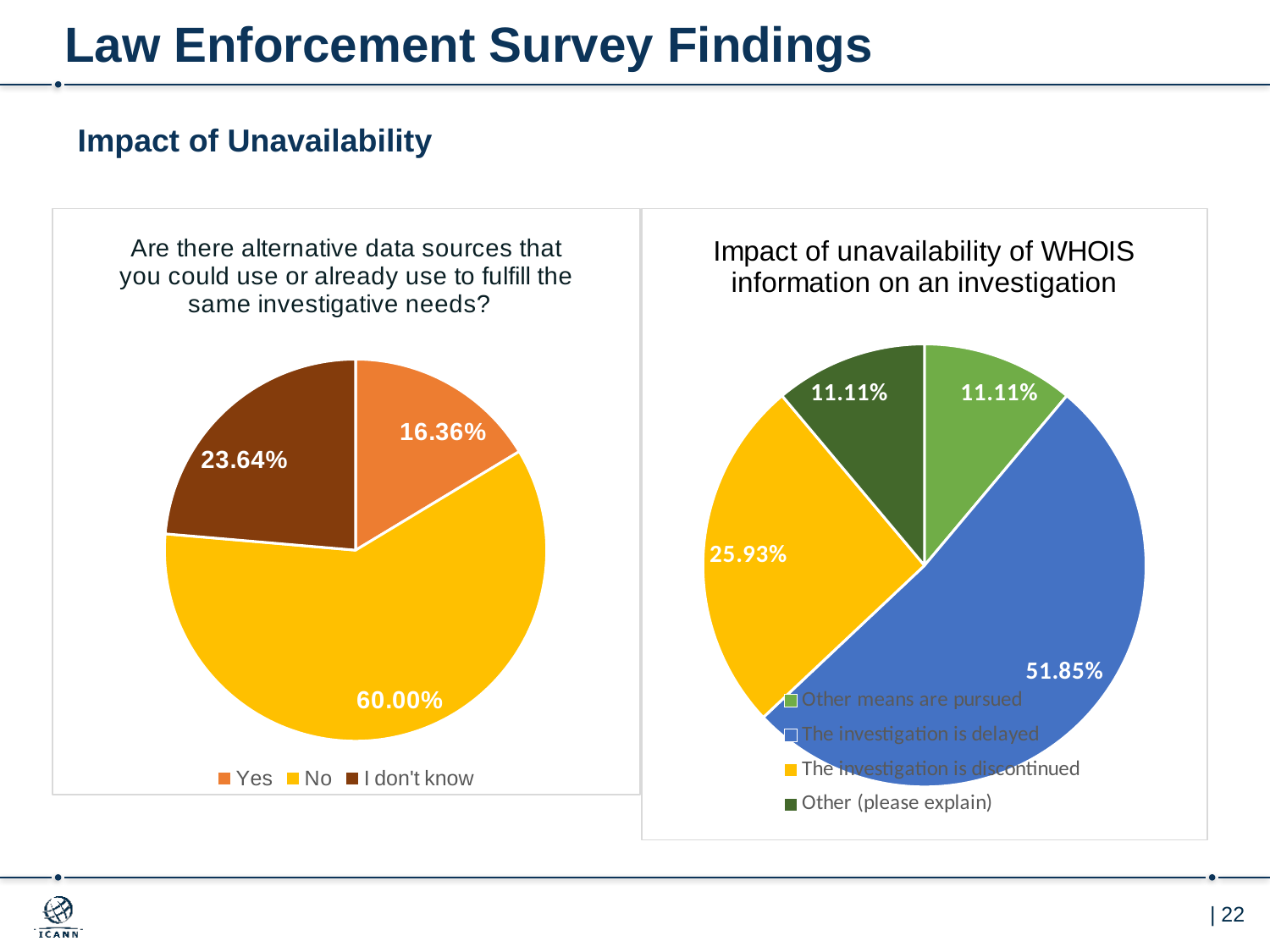
In the right chart ("Impact of unavailability of WHOIS information on an investigation"), which category has the largest share? The investigation is delayed In the left chart ("Are there alternative data sources..."), what share of respondents answered "I don't know"? 23.64% In the left chart ("Are there alternative data sources..."), what share of respondents answered "No"? 60.00% In the left chart ("Are there alternative data sources..."), which response has the smallest share? Yes In the right chart ("Impact of unavailability of WHOIS information on an investigation"), how many categories does the legend list? 4 In the left chart ("Are there alternative data sources..."), what is the difference in percentage points between "No" and "I don't know"? 36.36 In the left chart ("Are there alternative data sources..."), how many responses does the legend list? 3 What type of chart is used for the right chart ("Impact of unavailability of WHOIS information on an investigation")? Pie chart In the left chart ("Are there alternative data sources..."), what share of respondents answered "Yes"? 16.36% In the right chart ("Impact of unavailability of WHOIS information on an investigation"), what share corresponds to "The investigation is discontinued"? 25.93% In the right chart ("Impact of unavailability of WHOIS information on an investigation"), what share corresponds to "The investigation is delayed"? 51.85% In the left chart ("Are there alternative data sources..."), which response has the largest share? No